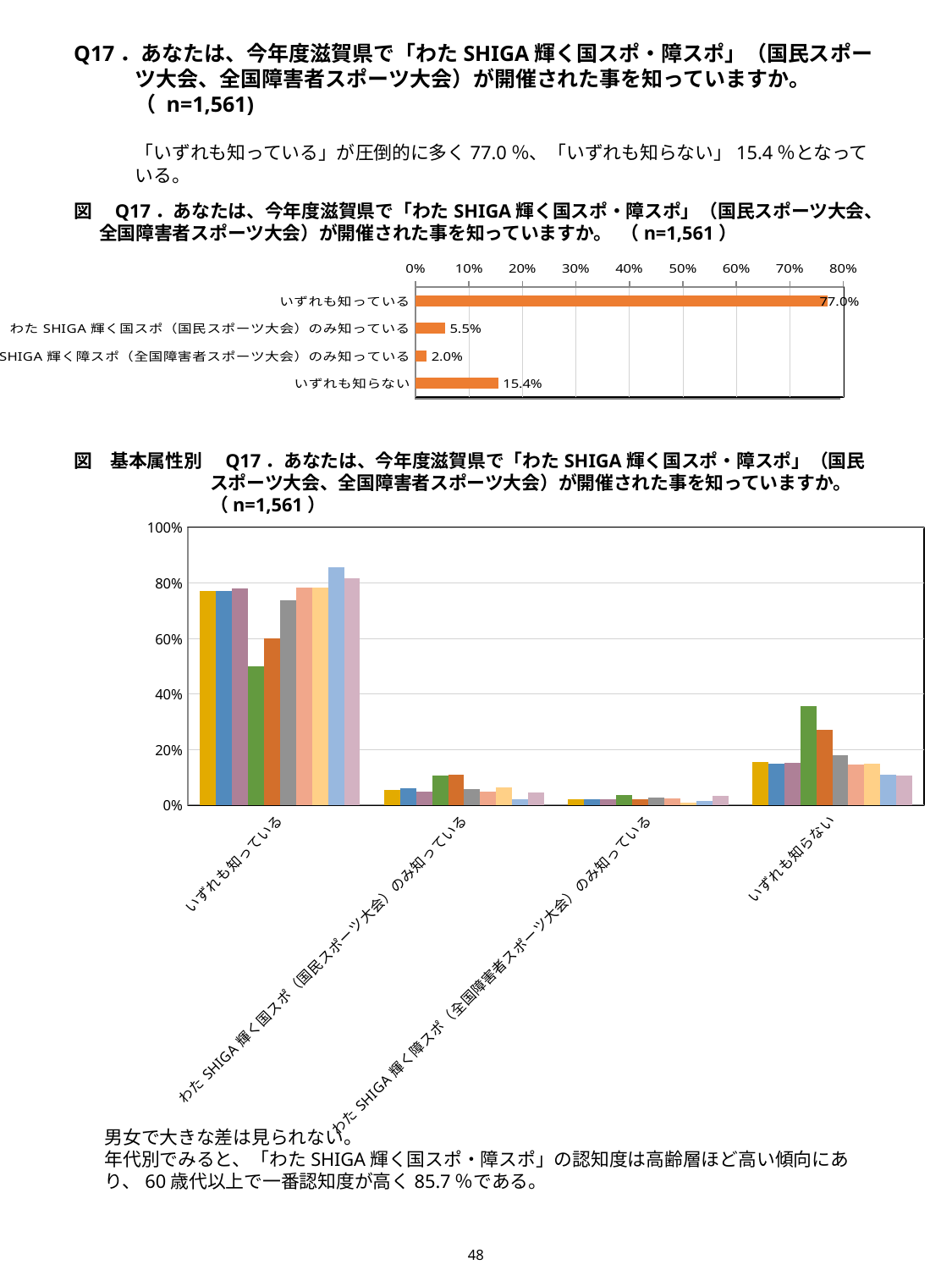
In the top chart, what is the value for 「わた SHIGA 輝く障スポ（全国障害者スポーツ大会）のみ知っている」? 2.0% In the top chart, what is the value for 「わた SHIGA 輝く国スポ（国民スポーツ大会）のみ知っている」? 5.5% What kind of chart is the top chart? Bar chart In the top chart, what is the value for 「いずれも知っている」? 77.0% In the top chart, which category has the highest value? いずれも知っている How many categories does the top chart show? 4 In the top chart, which category has the lowest value? わた SHIGA 輝く障スポ（全国障害者スポーツ大会）のみ知っている In the top chart, what is the difference between 「いずれも知っている」 and 「いずれも知らない」? 61.6% In the top chart, which is larger: 「いずれも知らない」 or 「わた SHIGA 輝く国スポ（国民スポーツ大会）のみ知っている」? いずれも知らない In the top chart, what is the value for 「いずれも知らない」? 15.4% In the top chart, what is the difference between 「わた SHIGA 輝く国スポ（国民スポーツ大会）のみ知っている」 and 「わた SHIGA 輝く障スポ（全国障害者スポーツ大会）のみ知っている」? 3.5% In the bottom chart, are all the bars in the 「いずれも知っている」 group greater or less than 40%? greater